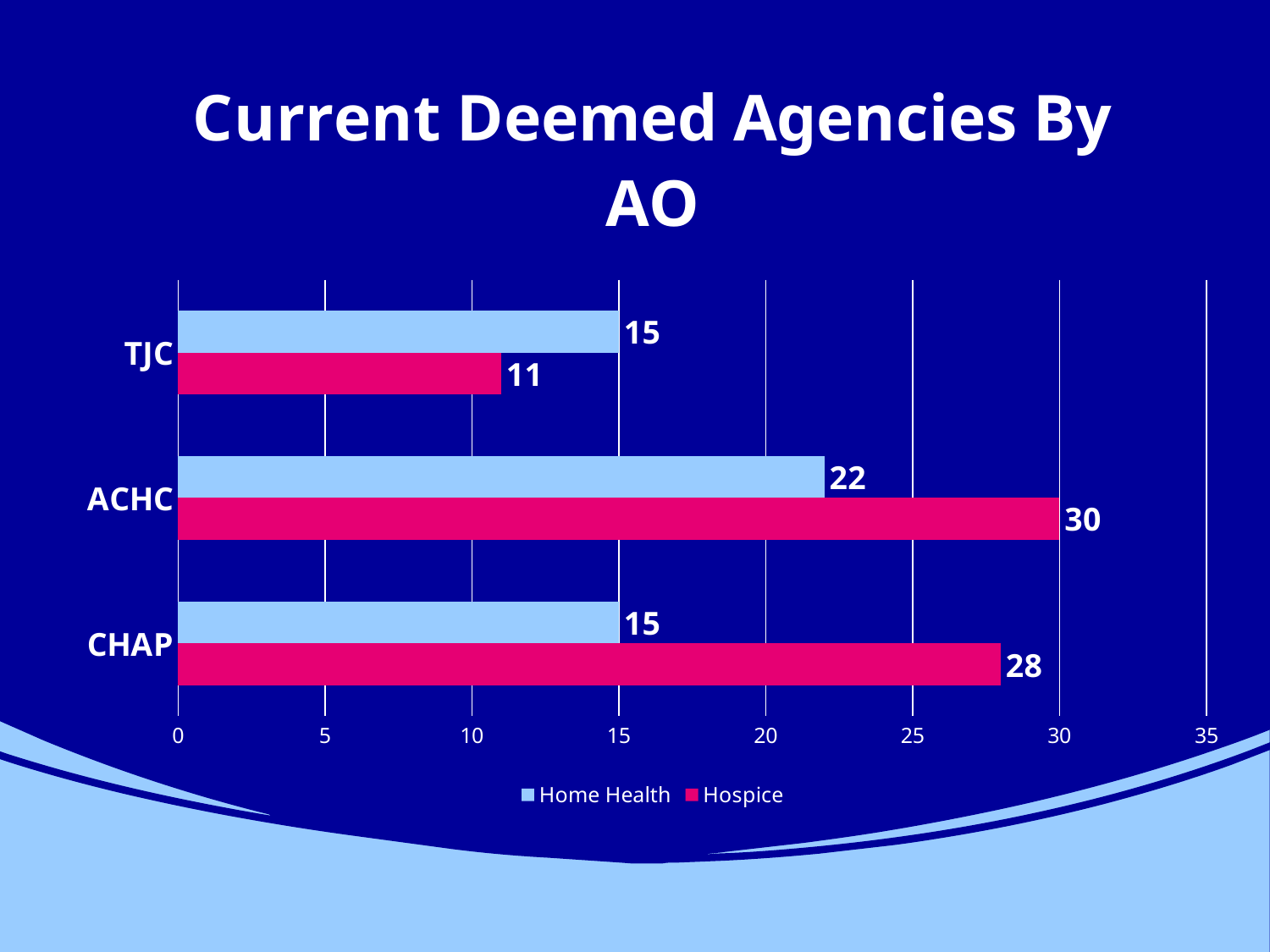
What is the Hospice value for CHAP? 28 How many agencies are shown on the chart? 3 Which is larger for CHAP, the Home Health value or the Hospice value? Hospice What kind of chart is shown on the slide? Bar chart How many series does the legend list? 2 Which agency has the lowest Hospice value? TJC What is the Home Health value for ACHC? 22 What is the Hospice value for TJC? 11 What is the title of the chart? Current Deemed Agencies By AO What is the difference between the Hospice and Home Health values for ACHC? 8 Which agency has the highest Home Health value? ACHC Which agency has the highest Hospice value? ACHC